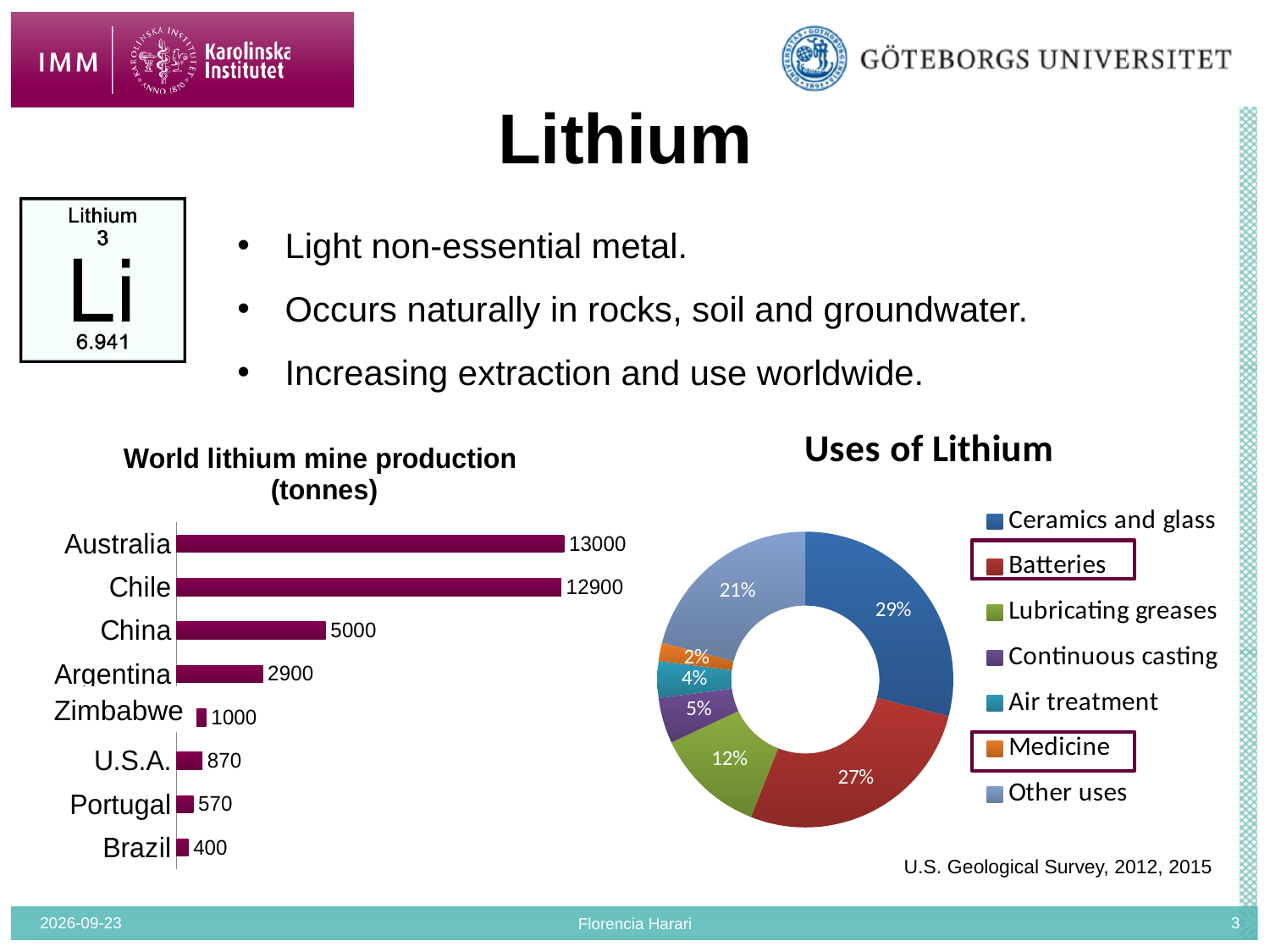
In the 'World lithium mine production (tonnes)' chart, what is the value for China? 5000 How many countries are shown in the 'World lithium mine production (tonnes)' chart? 8 In the 'World lithium mine production (tonnes)' chart, which is larger, the value for Argentina or the value for Zimbabwe? Argentina What kind of chart is 'World lithium mine production (tonnes)'? Bar chart In the 'Uses of Lithium' chart, which use has the smallest share? Medicine In the 'Uses of Lithium' chart, what share is Batteries? 27% In the 'World lithium mine production (tonnes)' chart, which country has the highest production? Australia In the 'World lithium mine production (tonnes)' chart, what is the difference between Australia and Chile? 100 How many entries does the legend of the 'Uses of Lithium' chart list? 7 In the 'World lithium mine production (tonnes)' chart, what is the value for U.S.A.? 870 In the 'World lithium mine production (tonnes)' chart, which country has the lowest production? Brazil In the 'Uses of Lithium' chart, which use has the largest share? Ceramics and glass